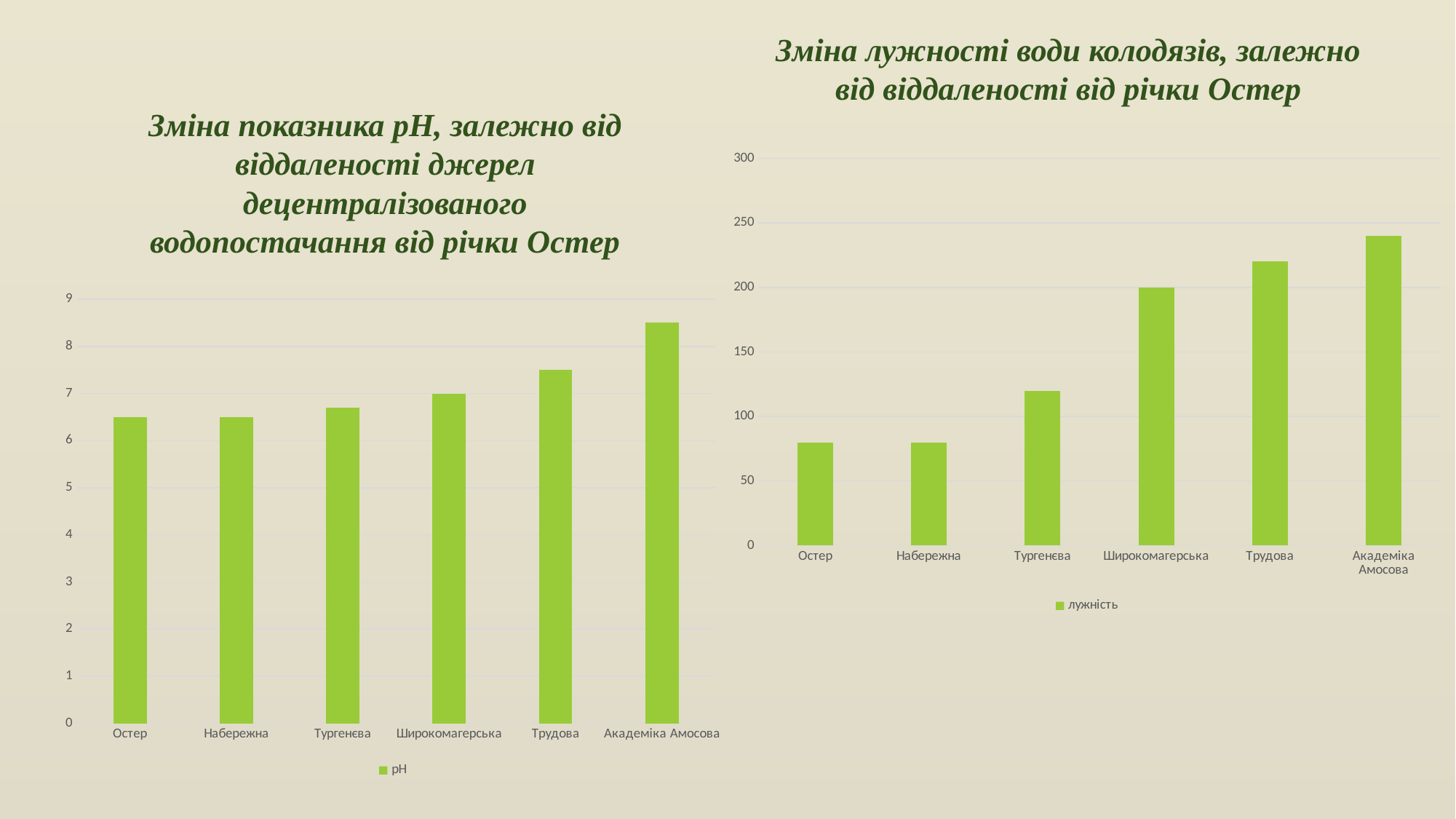
In the right chart ("Зміна лужності води колодязів"), do the values generally rise or fall from left to right along the x axis? rise In the right chart ("Зміна лужності води колодязів"), what is the value for Широкомагерська? 200 In the right chart ("Зміна лужності води колодязів"), how many categories are shown on the x axis? 6 What is the legend entry of the right chart ("Зміна лужності води колодязів")? лужність What kind of chart is the left chart titled "Зміна показника pH"? bar chart In the left chart ("Зміна показника pH"), which is larger: the value for Трудова or the value for Тургенєва? Трудова In the right chart ("Зміна лужності води колодязів"), is the value for Остер greater or less than 100? less In the left chart ("Зміна показника pH"), how many series does the legend list? 1 In the right chart ("Зміна лужності води колодязів"), is the value for Трудова greater or less than 200? greater In the left chart ("Зміна показника pH"), is the value for Академіка Амосова greater or less than 8? greater In the right chart ("Зміна лужності води колодязів"), which category has the highest value? Академіка Амосова In the left chart ("Зміна показника pH"), which category has the highest value? Академіка Амосова